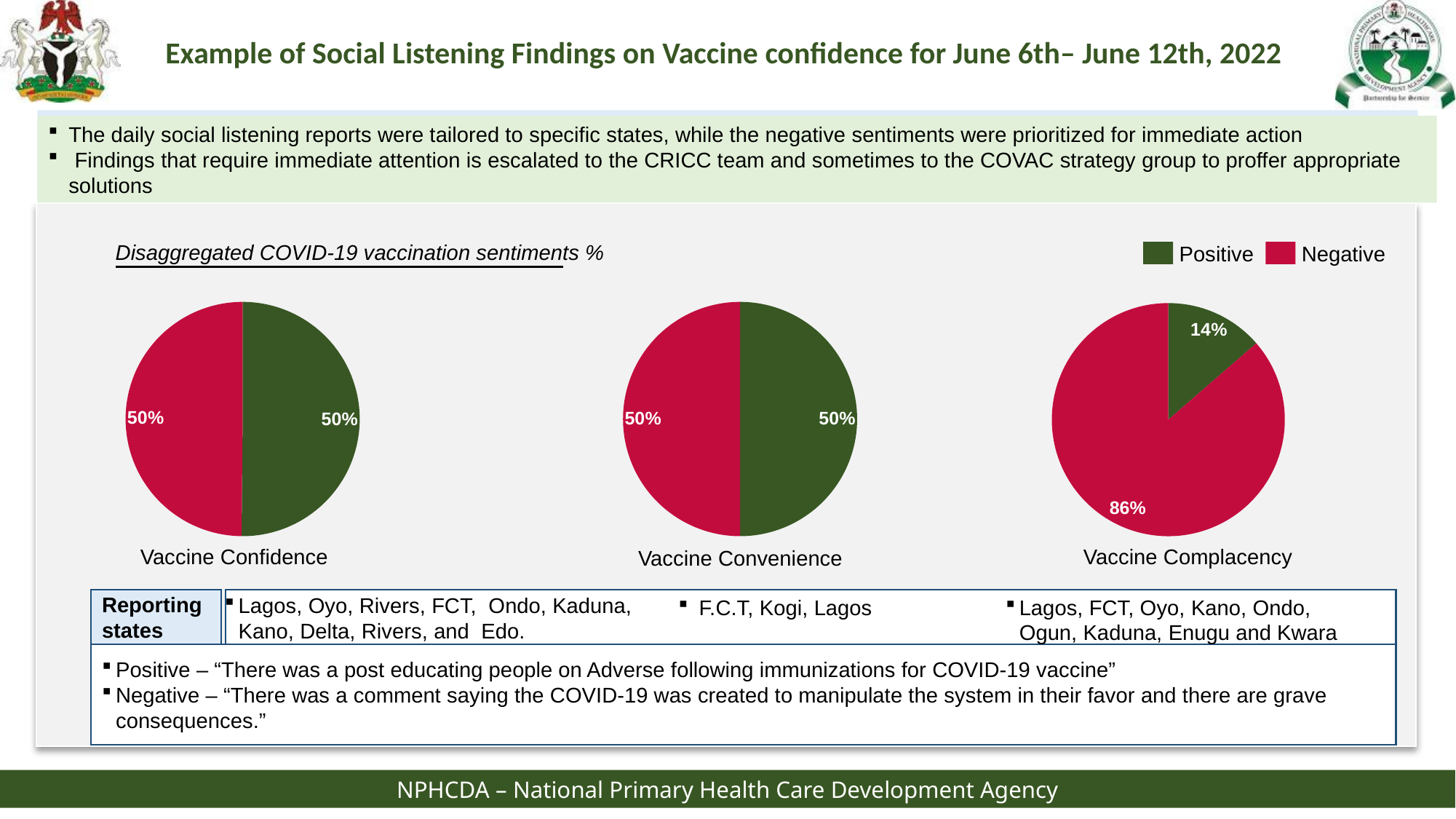
In the Vaccine Complacency pie chart, what share is Positive? 14% In the Vaccine Complacency pie chart, which sentiment has the larger slice? Negative In the Vaccine Complacency pie chart, what share is Negative? 86% How many sentiment categories does the legend list? 2 Which colour represents Negative sentiment in the pie charts? Red In the Vaccine Confidence pie chart, what share is Positive? 50% How many pie charts are shown on the slide? 3 In the Vaccine Convenience pie chart, what share is Negative? 50% In the Vaccine Complacency pie chart, what is the difference between the Negative and Positive shares? 72% What kind of chart is used to show the Vaccine Confidence sentiments? Pie chart In the Vaccine Complacency pie chart, which sentiment has the smaller slice? Positive In the Vaccine Complacency pie chart, is the Positive share greater or less than 50%? less